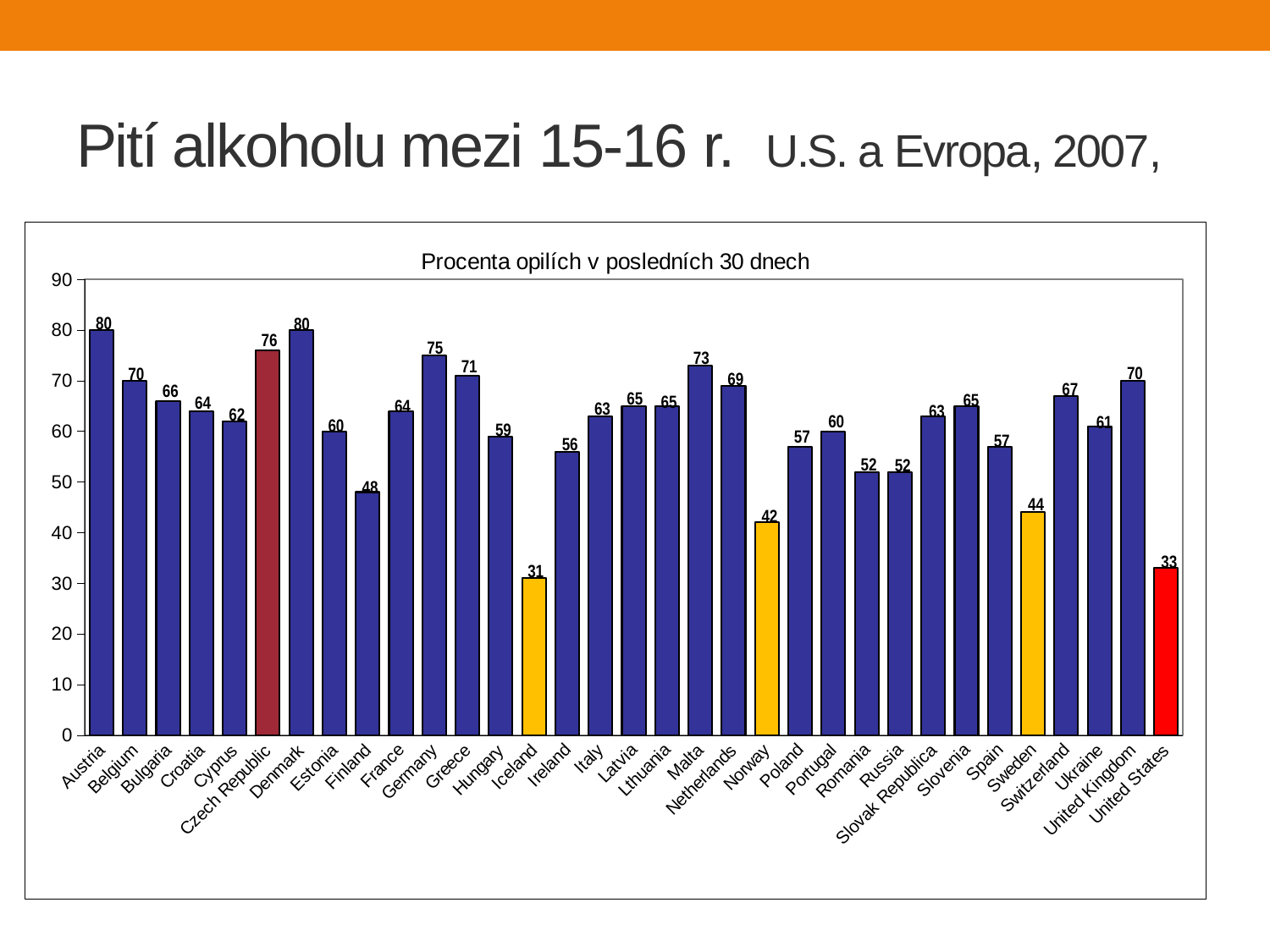
What is the value for Norway? 42 What is the difference between the values for Czech Republic and United States? 43 How many countries are shown in the chart? 33 Which country has the lowest value? Iceland Which is larger, the value for Finland or the value for Sweden? Finland What kind of chart is shown on the slide? Bar chart What is the value for Germany? 75 What is the value for Czech Republic? 76 What is the title of the chart? Procenta opilích v posledních 30 dnech What is the value for United States? 33 What is the difference between the values for Austria and Belgium? 10 Which is larger, the value for Malta or the value for Netherlands? Malta